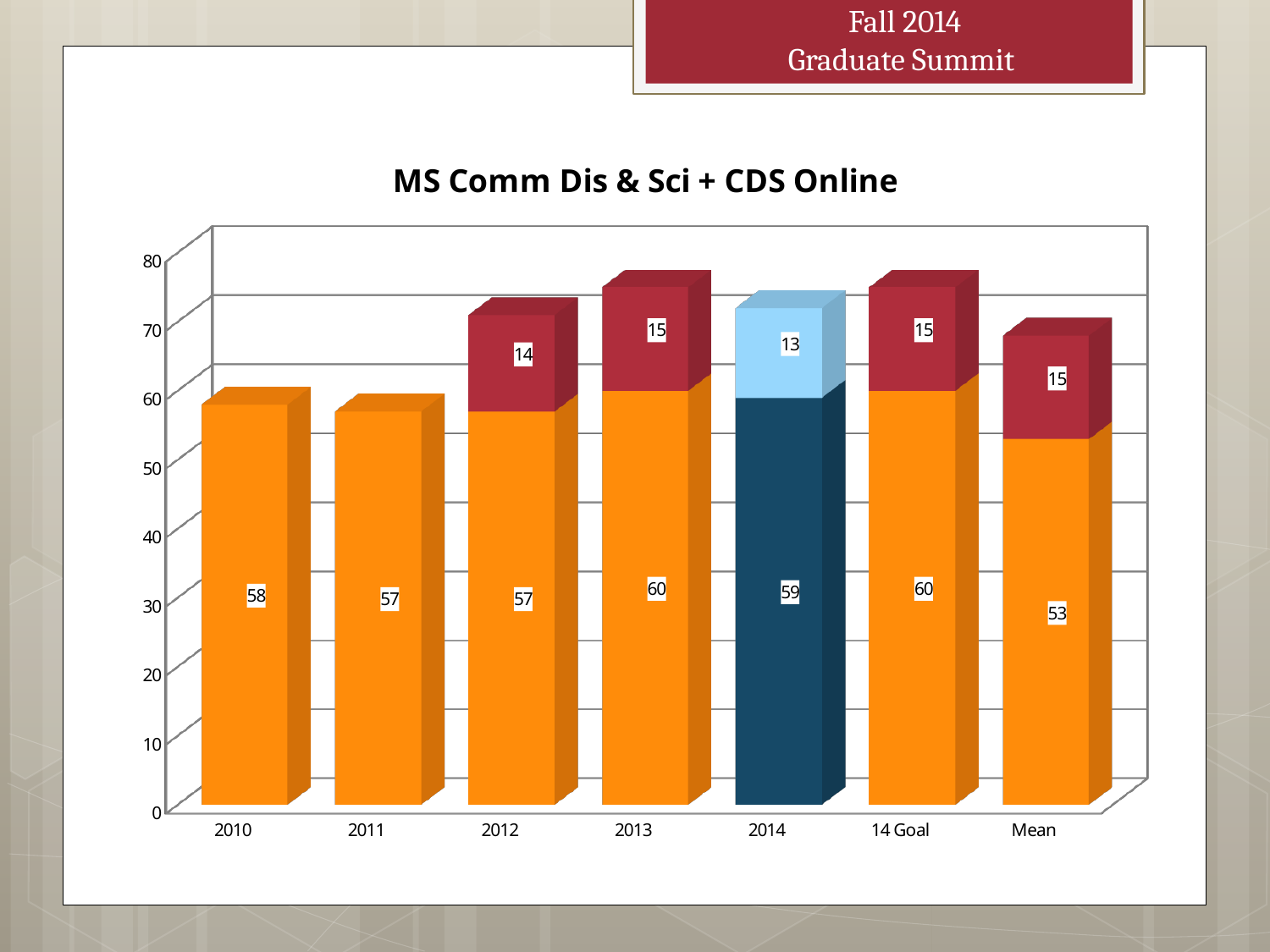
What is the value of the top segment for 2014? 13 What is the value of the bottom segment for Mean? 53 What is the total of the stacked bar for 2013? 75 Which is larger, the bottom segment value for 2010 or for 2011? 2010 What is the title of the chart? MS Comm Dis & Sci + CDS Online What is the value of the bottom (orange) segment for 2010? 58 What type of chart is shown on the slide? Stacked bar chart Which category has the lowest value for the bottom (orange) segment? Mean What is the difference between the bottom segment values for 2013 and Mean? 7 What is the total of the stacked bar for 2014? 72 How many categories are shown along the x axis? 7 What is the value of the top segment for 2012? 14